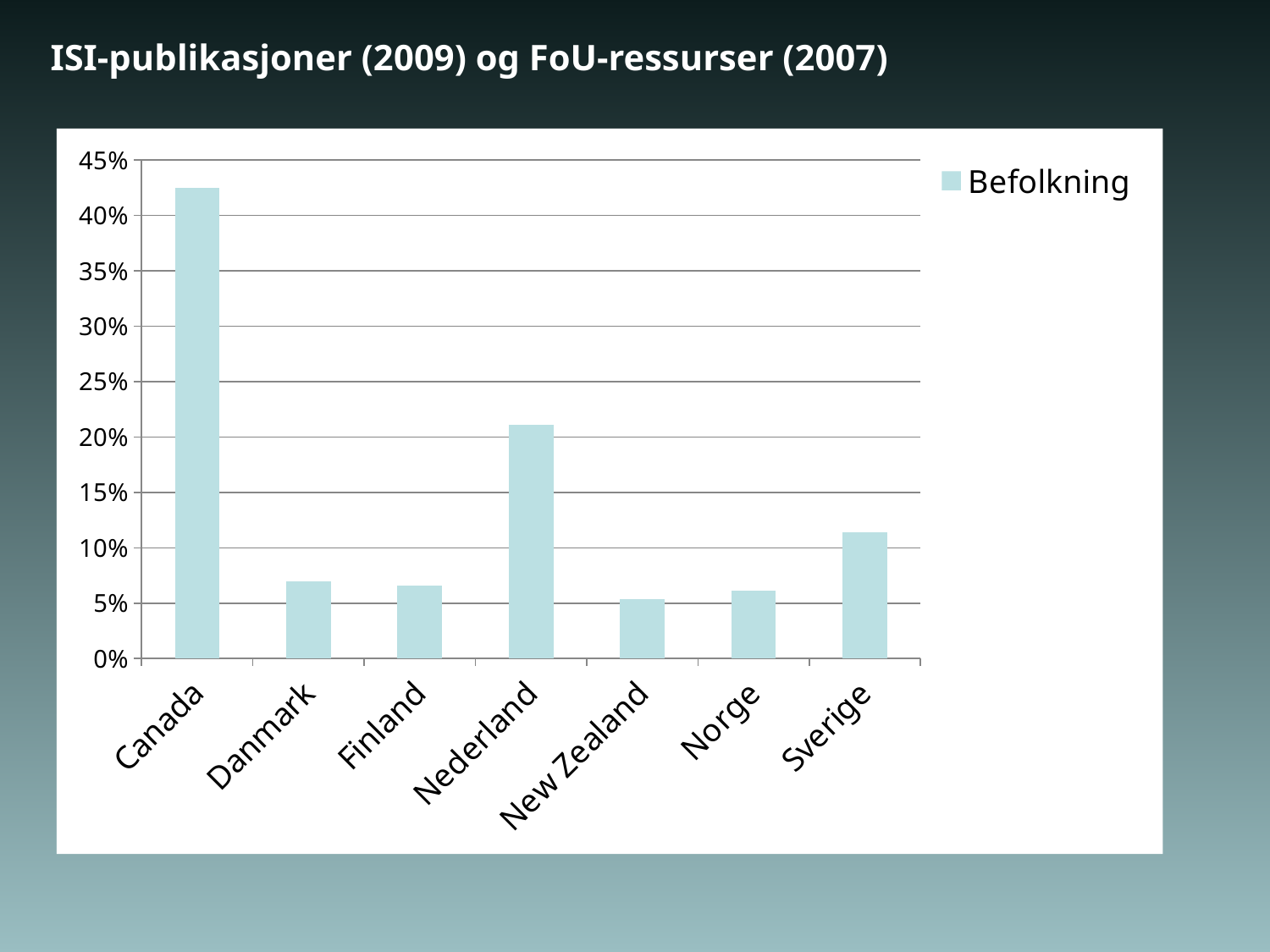
Which is larger, the value for Nederland or the value for Sverige? Nederland Which is larger, the value for Norge or the value for Sverige? Sverige Is the value for Canada greater or less than 40%? greater What kind of chart is shown on the slide? bar chart Is the value for Danmark greater or less than 10%? less How many series does the legend list? 1 Is the value for New Zealand greater or less than 10%? less How many countries are shown on the x axis? 7 Which country has the highest Befolkning value? Canada What is the name of the series shown in the legend? Befolkning